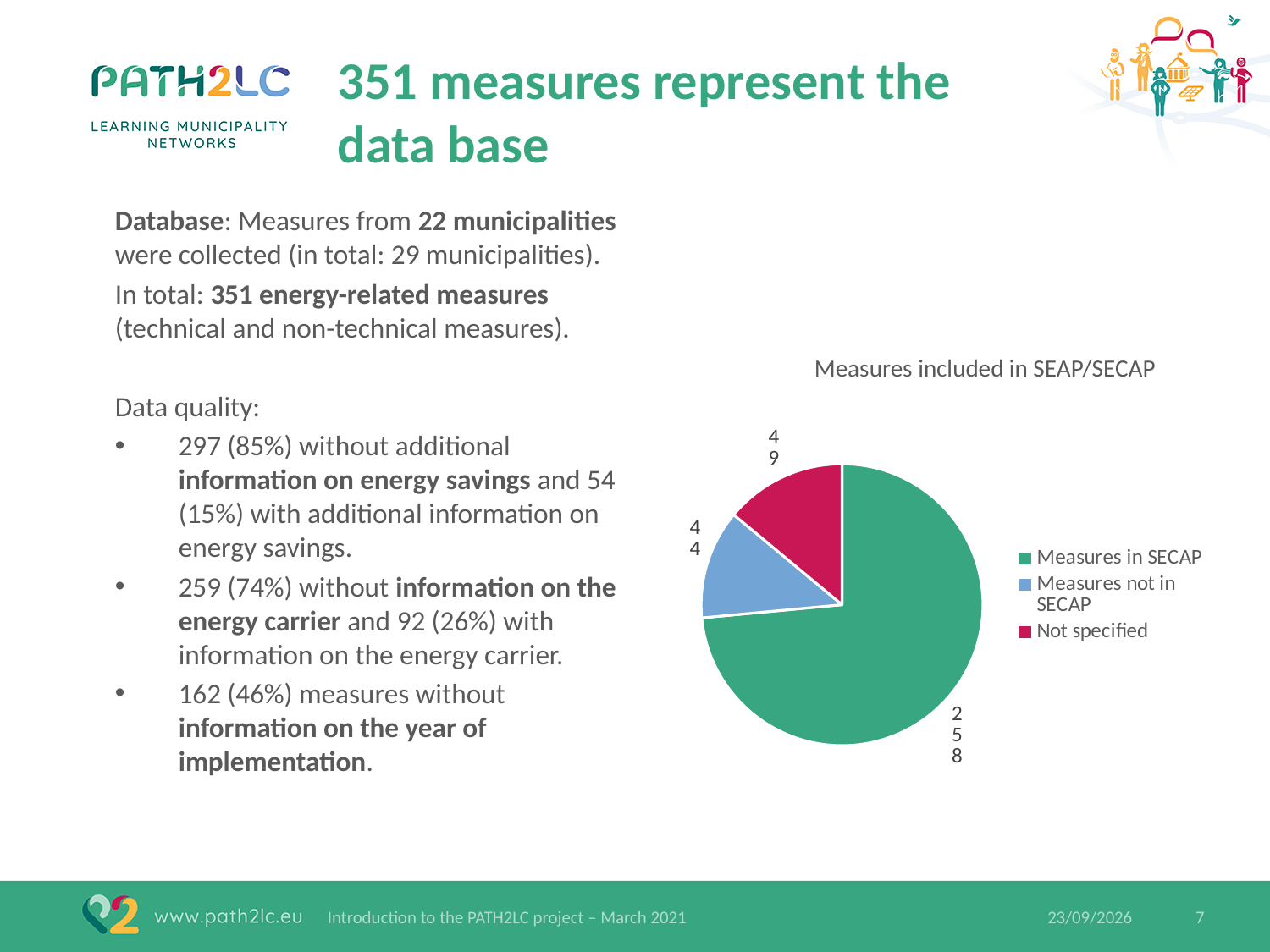
Which category has the largest slice of the pie? Measures in SECAP How many categories does the legend of the pie chart list? 3 Which category has the smallest slice of the pie? Measures not in SECAP What is the value for Not specified? 49 What is the value for Measures in SECAP? 258 What is the value for Measures not in SECAP? 44 What is the total of all slices in the pie chart? 351 What kind of chart is shown on the slide? Pie chart What is the title of the chart? Measures included in SEAP/SECAP What is the difference between Not specified and Measures not in SECAP? 5 What is the difference between Measures in SECAP and Not specified? 209 Which colour represents Not specified in the pie chart? Red